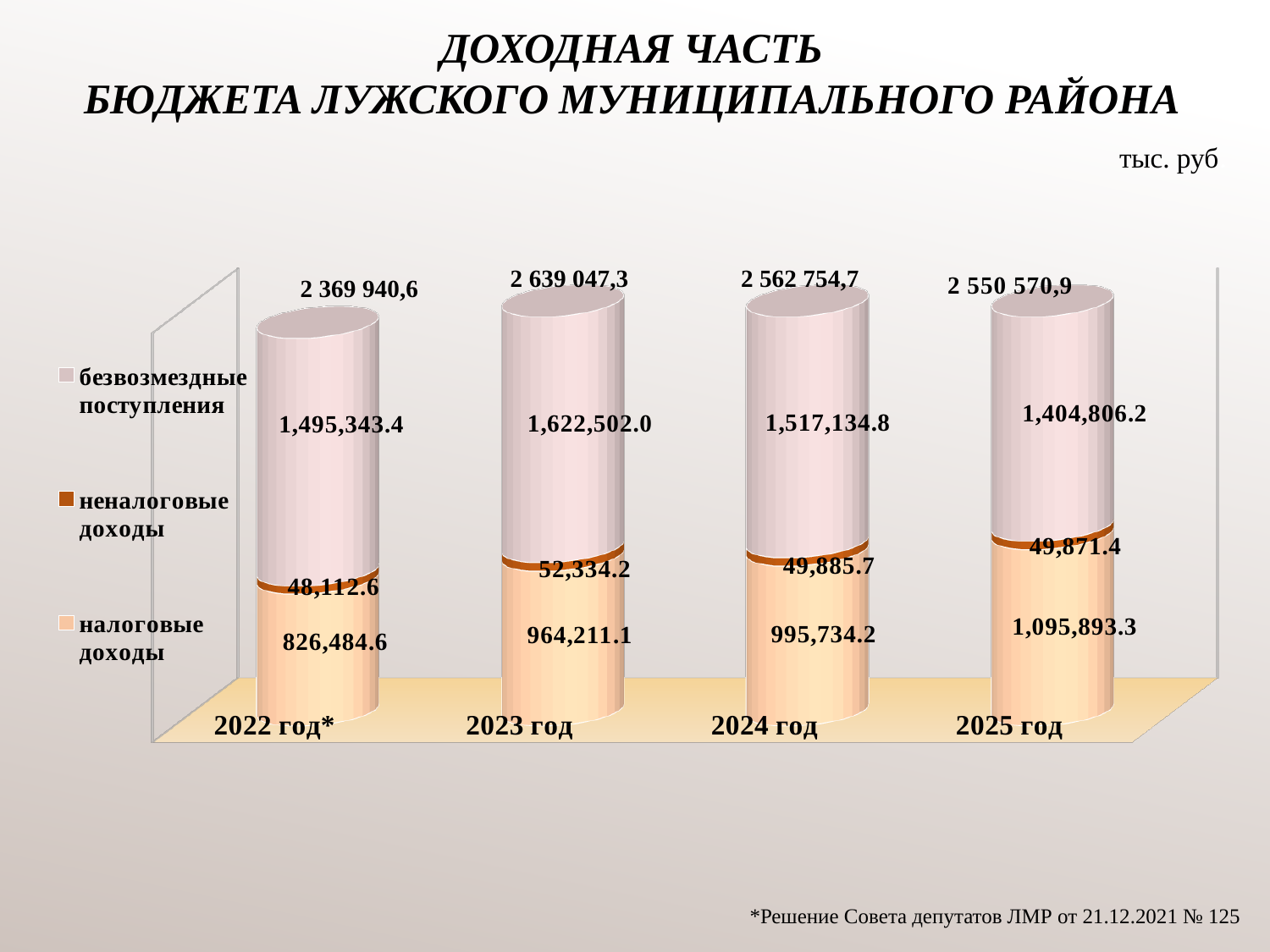
Which year has the highest total revenue? 2023 год What is the value of неналоговые доходы for 2022 год*? 48,112.6 Which year has the highest value of безвозмездные поступления? 2023 год What is the value of безвозмездные поступления for 2025 год? 1,404,806.2 Do the values of налоговые доходы rise or fall from 2022 год* to 2025 год? rise What is the difference between налоговые доходы in 2025 год and 2022 год*? 269,408.7 How many series does the legend list? 3 Which year has the lowest value of налоговые доходы? 2022 год* What is the value of налоговые доходы for 2023 год? 964,211.1 Which is larger, неналоговые доходы in 2023 год or in 2024 год? 2023 год What is the total revenue shown above the bar for 2024 год? 2 562 754,7 How many years are shown on the chart? 4